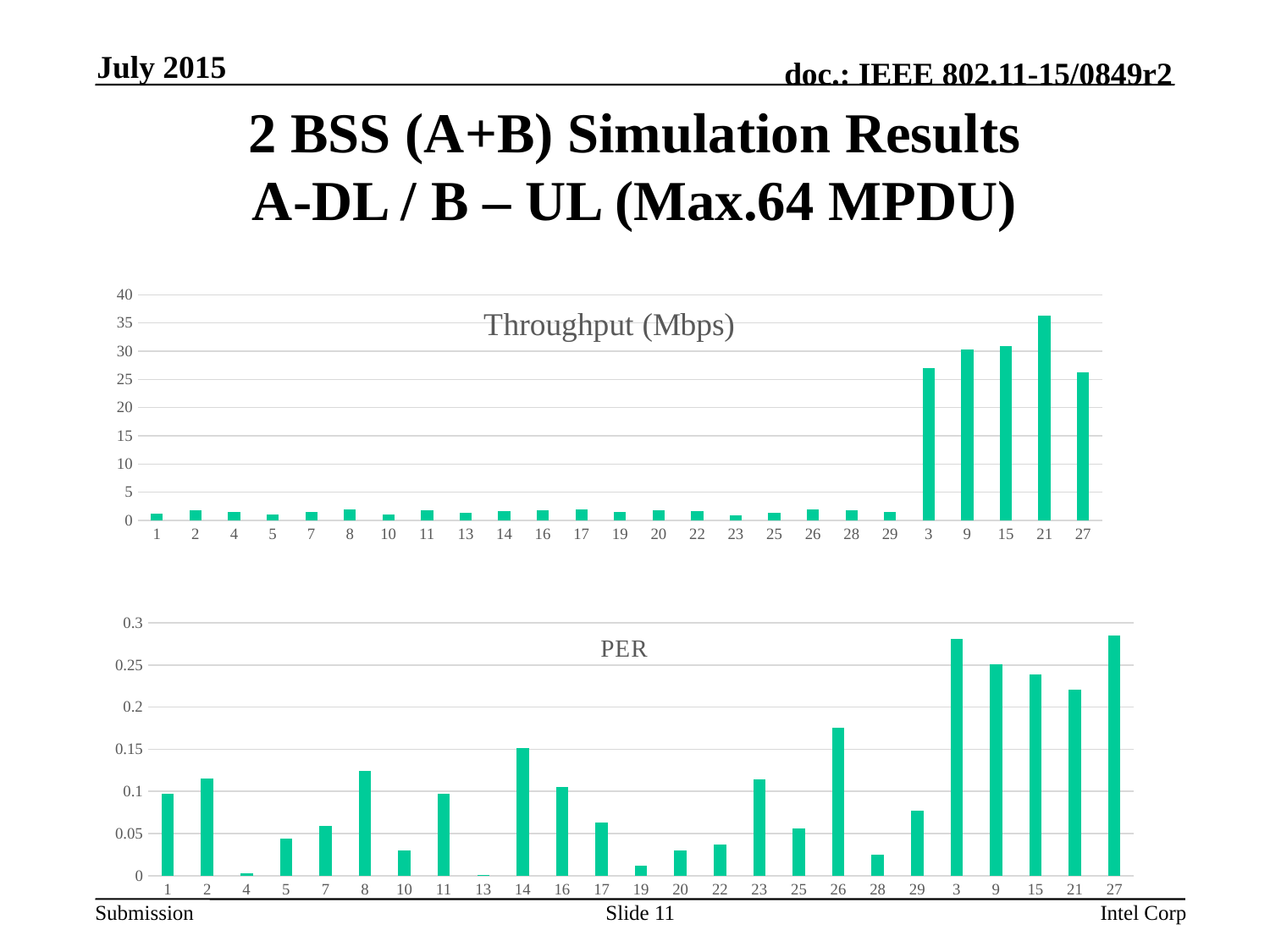
In the PER chart, is the value for category 19 greater or less than 0.05? less In the Throughput (Mbps) chart, is the value for category 1 greater or less than 5? less In the PER chart, which is larger, the value for category 8 or the value for category 10? 8 In the PER chart, which is larger, the value for category 26 or the value for category 23? 26 In the PER chart, is the value for category 26 greater or less than 0.15? greater In the Throughput (Mbps) chart, which is larger, the value for category 3 or the value for category 29? 3 What is the title of the top chart on the slide? Throughput (Mbps) How many categories are shown on the x axis of the Throughput (Mbps) chart? 25 In the Throughput (Mbps) chart, which category has the highest value? 21 What kind of chart is the Throughput (Mbps) chart? bar chart